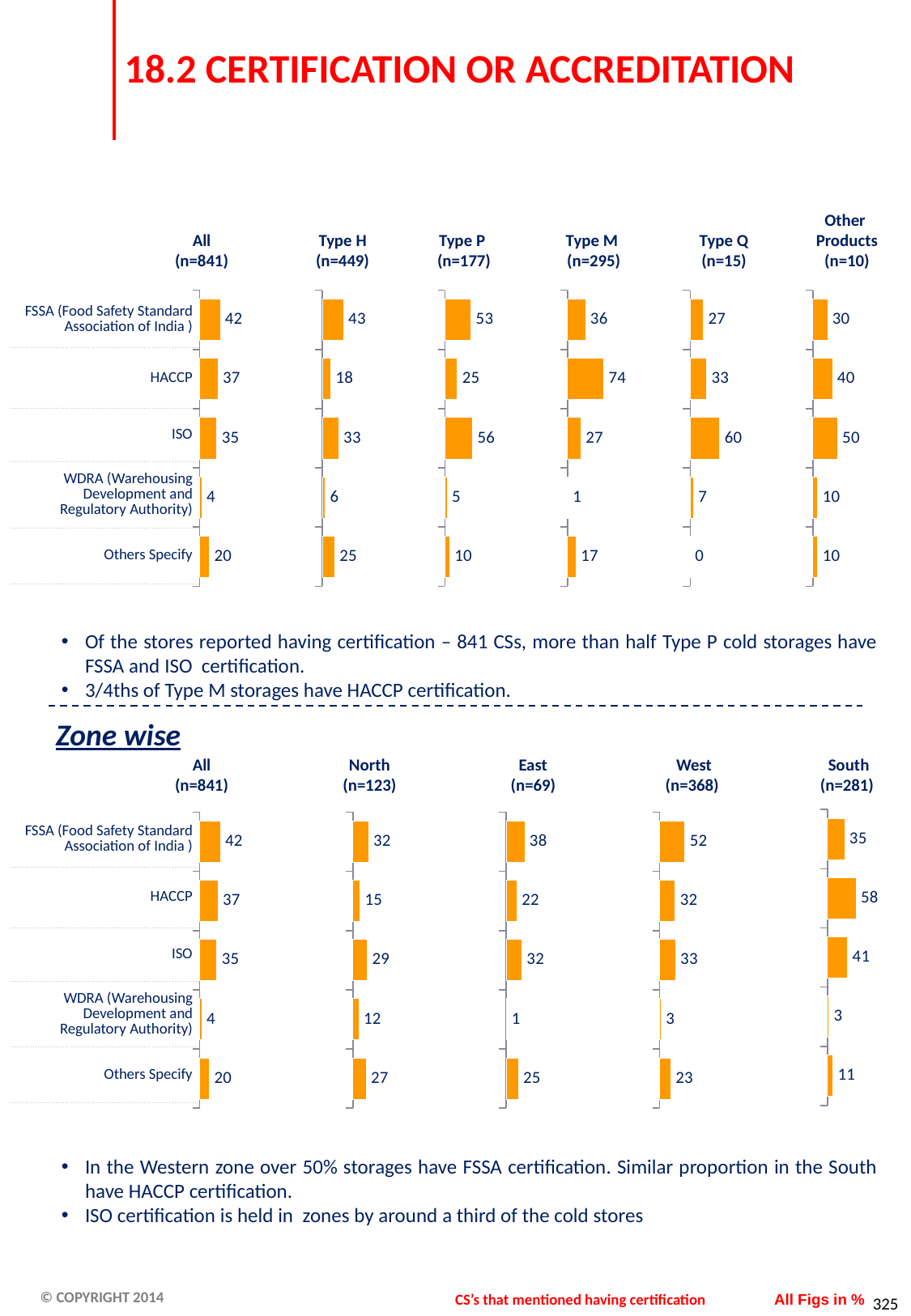
In the top chart (by storage type), what is the value for HACCP under Type M (n=295)? 74 In the top chart (by storage type), which certification has the lowest value in the Type M (n=295) column? WDRA (Warehousing Development and Regulatory Authority) In the Zone wise chart, what is the value for HACCP in the South (n=281) column? 58 In the Zone wise chart, which zone has the highest FSSA value? West (n=368) How many certification categories are listed in the Zone wise chart? 5 In the top chart (by storage type), what is the difference between the FSSA values for Type P (n=177) and Type Q (n=15)? 26 In the top chart (by storage type), which is larger: the HACCP value for Type H (n=449) or for Type P (n=177)? Type P (n=177) In the top chart (by storage type), what is the value for ISO under Type P (n=177)? 56 In the Zone wise chart, what is the difference between the WDRA values for North (n=123) and East (n=69)? 11 In the top chart (by storage type), which certification has the highest value in the Type Q (n=15) column? ISO What type of chart is used on this slide? Bar chart In the Zone wise chart, which is larger: the Others Specify value for North (n=123) or for South (n=281)? North (n=123)